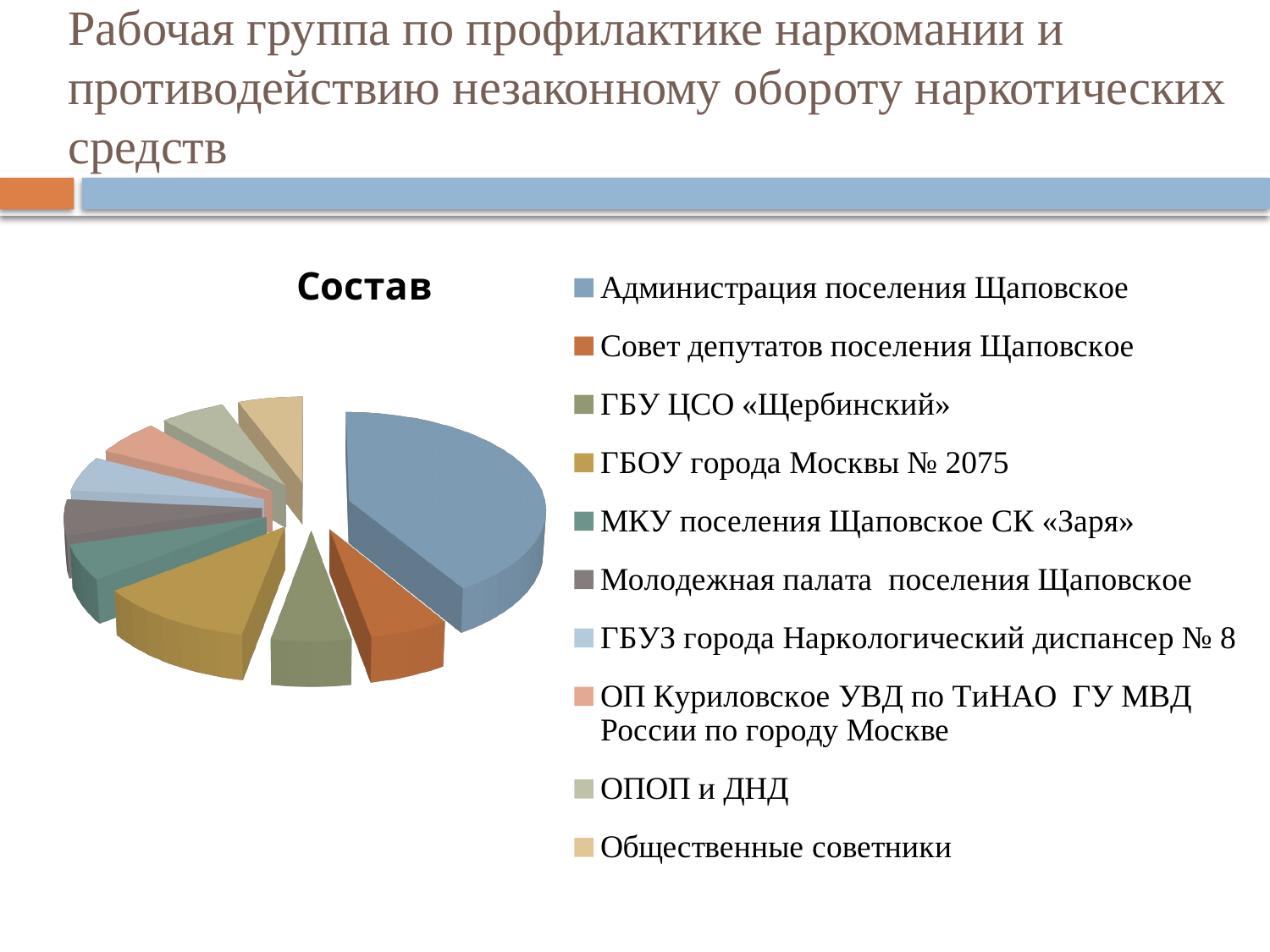
Which slice is larger: Администрация поселения Щаповское or ГБУ ЦСО «Щербинский»? Администрация поселения Щаповское Which category is listed last in the legend? Общественные советники Which slice is larger: ГБОУ города Москвы № 2075 or Молодежная палата поселения Щаповское? ГБОУ города Москвы № 2075 Which slice is larger: Администрация поселения Щаповское or Совет депутатов поселения Щаповское? Администрация поселения Щаповское Which category has the largest slice of the pie? Администрация поселения Щаповское What is the title of the chart? Состав What colour is the slice for Администрация поселения Щаповское? blue What kind of chart is shown on the slide? pie chart How many categories does the pie chart's legend list? 10